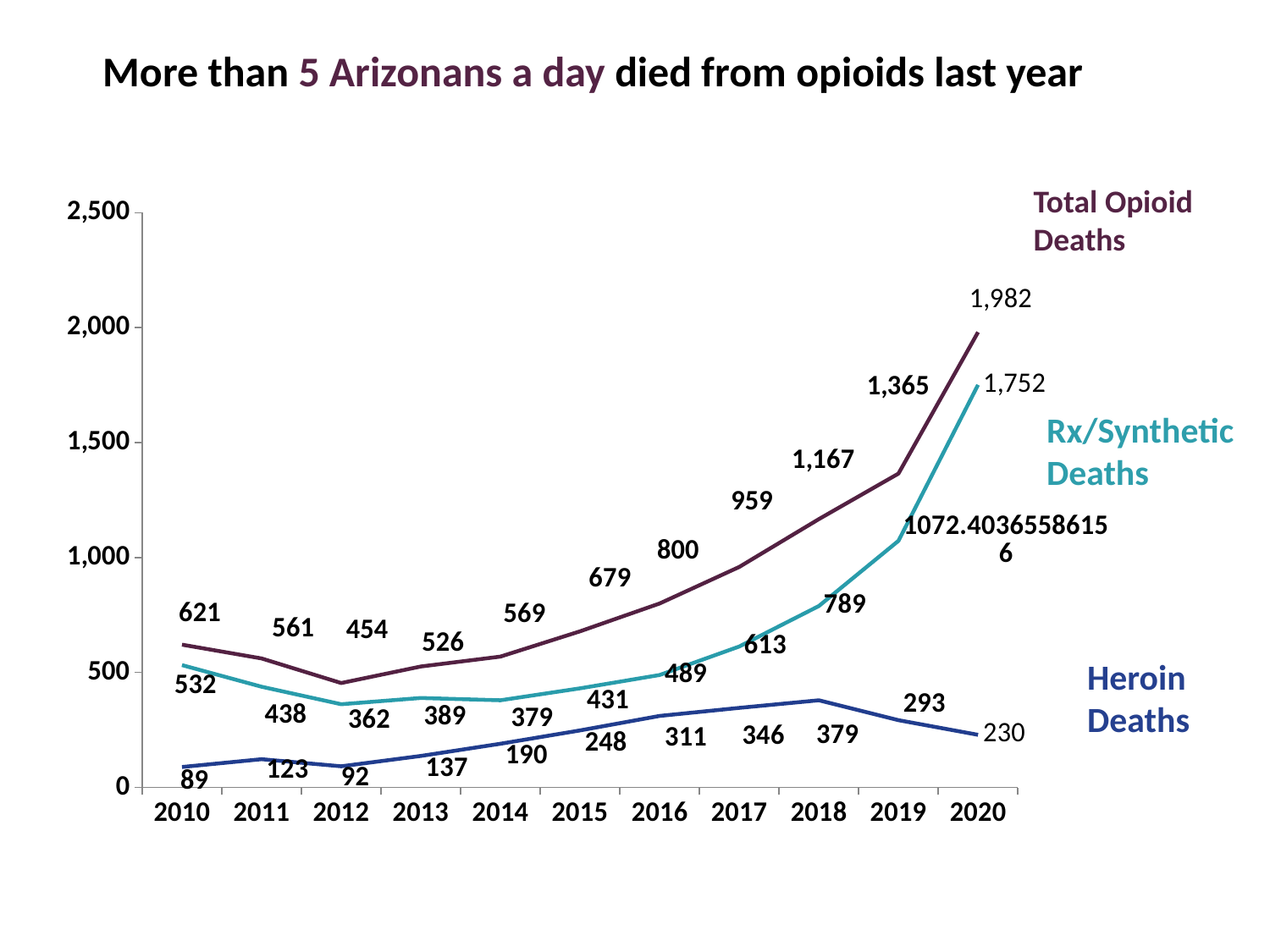
What is the value for Total Opioid Deaths in 2012? 454 How many series does the chart show? 3 In which year were Total Opioid Deaths lowest? 2012 What is the value for Total Opioid Deaths in 2020? 1,982 What is the value for Heroin Deaths in 2018? 379 Which is larger: Rx/Synthetic Deaths in 2018 or Heroin Deaths in 2018? Rx/Synthetic Deaths in 2018 What is the value for Rx/Synthetic Deaths in 2020? 1,752 In which year were Heroin Deaths highest? 2018 How many years are plotted along the x axis? 11 What kind of chart is shown on the slide? line chart Do Total Opioid Deaths rise or fall from 2014 to 2020? rise What is the difference between Total Opioid Deaths in 2020 and in 2019? 617